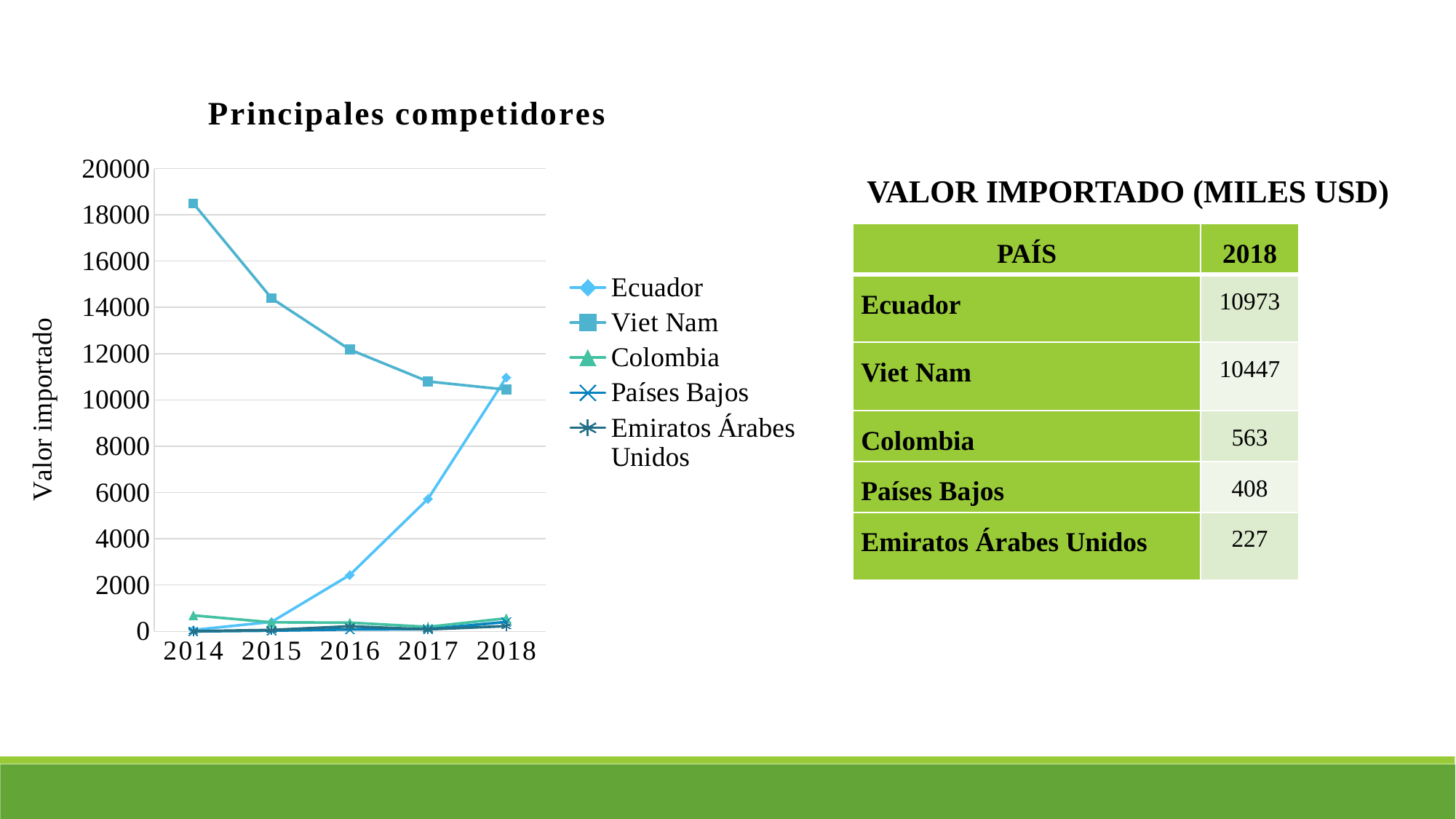
In the 'Principales competidores' chart, does the Viet Nam line rise or fall from 2014 to 2018? fall Which country had the lowest imported value in 2018? Emiratos Árabes Unidos In the 'Principales competidores' chart, is the value for Viet Nam in 2014 greater or less than 18000? greater What kind of chart is 'Principales competidores'? line chart How many years are shown on the x axis of the 'Principales competidores' chart? 5 In the 'Principales competidores' chart, is the value for Viet Nam in 2016 greater or less than 14000? less In the 'Principales competidores' chart, is the value for Ecuador in 2017 greater or less than 4000? greater In the 'Principales competidores' chart, does the Ecuador line rise or fall from 2015 to 2018? rise How many series does the legend of the 'Principales competidores' chart list? 5 According to the slide, what was the imported value for Ecuador in 2018? 10973 In the 'Principales competidores' chart, which had the higher value in 2014, Viet Nam or Ecuador? Viet Nam What is the label of the y axis in the 'Principales competidores' chart? Valor importado